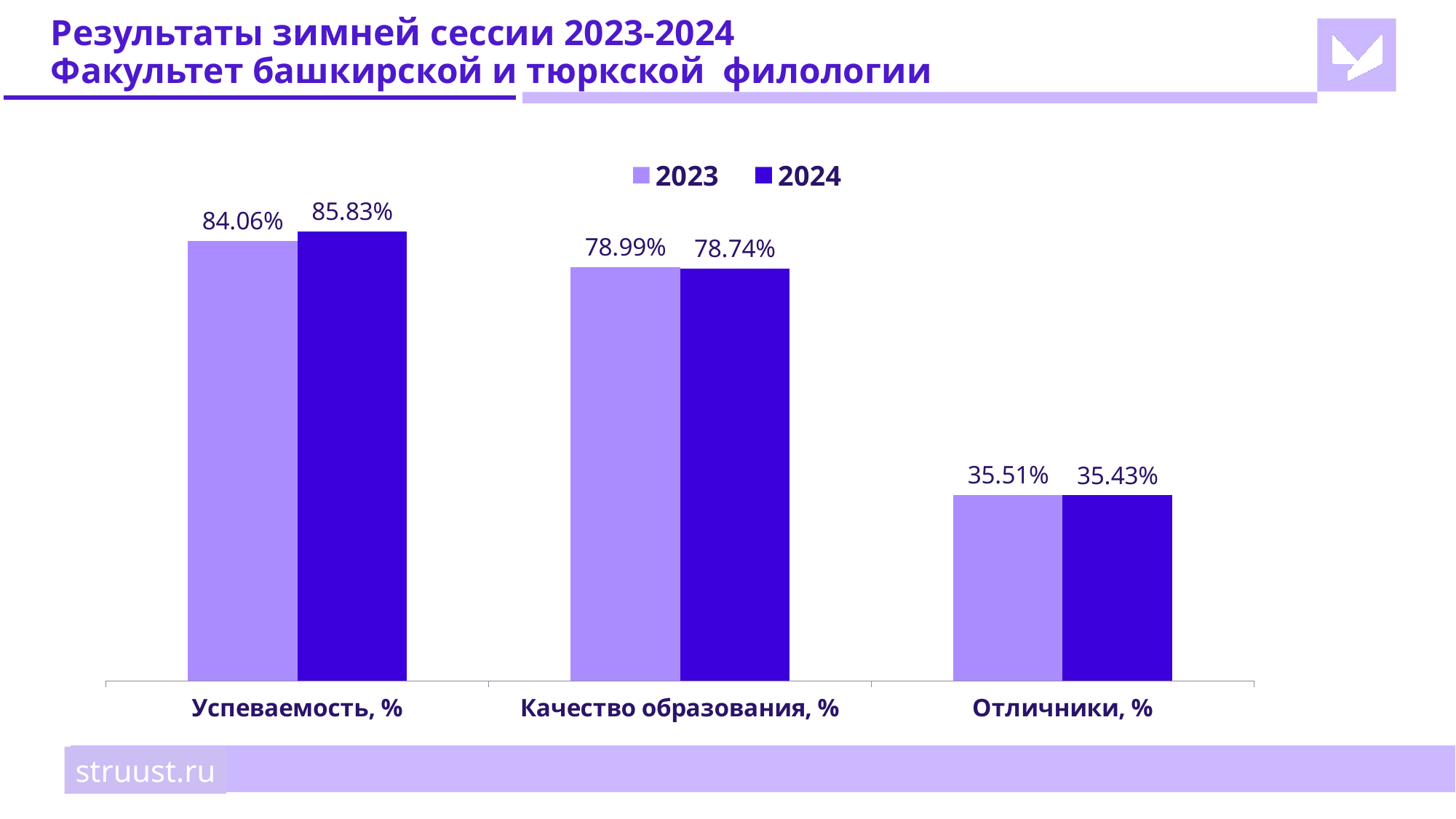
How many series does the legend list? 2 Which category has the highest 2024 value? Успеваемость, % What kind of chart is shown on the slide? Bar chart What is the 2024 value for Отличники, %? 35.43% How many categories are shown on the x axis? 3 What is the 2024 value for Качество образования, %? 78.74% Which category has the lowest 2023 value? Отличники, % What is the 2023 value for Успеваемость, %? 84.06% Which series is shown in the darker purple colour? 2024 What is the difference between the 2024 and 2023 values for Успеваемость, %? 1.77% Which is larger for Качество образования, %: the 2023 value or the 2024 value? 2023 What is the 2023 value for Отличники, %? 35.51%